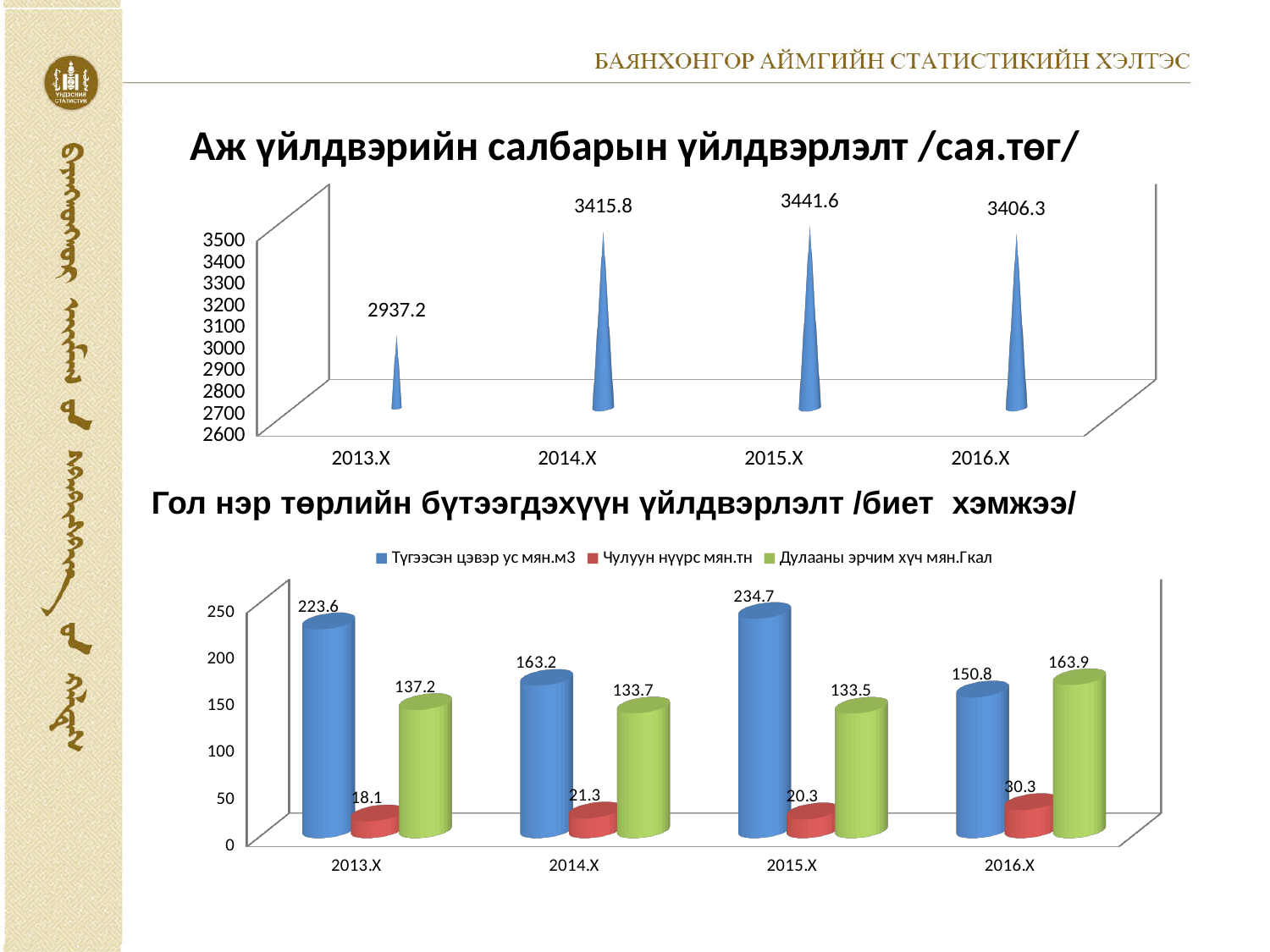
In the bottom chart (Гол нэр төрлийн бүтээгдэхүүн үйлдвэрлэлт /биет хэмжээ/), which year has the highest value for Дулааны эрчим хүч мян.Гкал? 2016.X In the top chart (Аж үйлдвэрийн салбарын үйлдвэрлэлт /сая.төг/), what is the value for 2013.X? 2937.2 In the bottom chart (Гол нэр төрлийн бүтээгдэхүүн үйлдвэрлэлт /биет хэмжээ/), what is the difference between the Түгээсэн цэвэр ус мян.м3 values for 2013.X and 2014.X? 60.4 In the top chart (Аж үйлдвэрийн салбарын үйлдвэрлэлт /сая.төг/), what is the difference between the 2014.X and 2013.X values? 478.6 In the bottom chart (Гол нэр төрлийн бүтээгдэхүүн үйлдвэрлэлт /биет хэмжээ/), what is the value of Түгээсэн цэвэр ус мян.м3 for 2015.X? 234.7 In the bottom chart (Гол нэр төрлийн бүтээгдэхүүн үйлдвэрлэлт /биет хэмжээ/), which is larger for 2016.X: Түгээсэн цэвэр ус мян.м3 or Дулааны эрчим хүч мян.Гкал? Дулааны эрчим хүч мян.Гкал In the bottom chart (Гол нэр төрлийн бүтээгдэхүүн үйлдвэрлэлт /биет хэмжээ/), what is the value of Чулуун нүүрс мян.тн for 2016.X? 30.3 What kind of chart is the bottom chart (Гол нэр төрлийн бүтээгдэхүүн үйлдвэрлэлт /биет хэмжээ/)? Bar chart In the top chart (Аж үйлдвэрийн салбарын үйлдвэрлэлт /сая.төг/), which year has the lowest value? 2013.X In the top chart (Аж үйлдвэрийн салбарын үйлдвэрлэлт /сая.төг/), which year has the highest value? 2015.X In the top chart (Аж үйлдвэрийн салбарын үйлдвэрлэлт /сая.төг/), how many years are shown on the x axis? 4 In the bottom chart (Гол нэр төрлийн бүтээгдэхүүн үйлдвэрлэлт /биет хэмжээ/), how many series does the legend list? 3